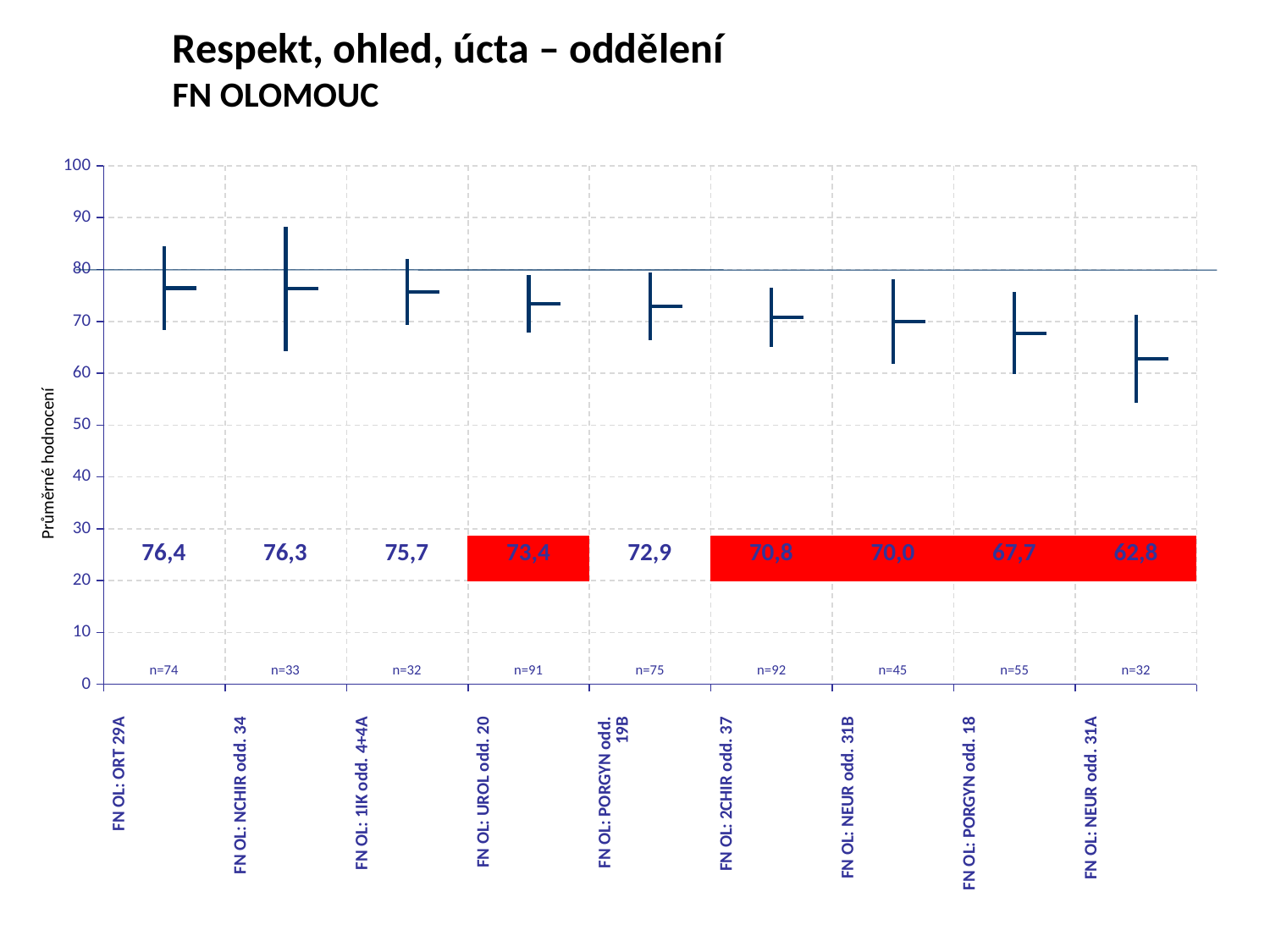
What is the average rating for FN OL: ORT 29A? 76,4 Which department has the highest average rating? FN OL: ORT 29A Which department has the lowest average rating? FN OL: NEUR odd. 31A What is the difference between the average ratings of FN OL: ORT 29A and FN OL: NEUR odd. 31A? 13,6 How many departments are shown on the chart? 9 Is the average rating for FN OL: NEUR odd. 31B greater or less than 80? less What is the number of respondents (n) for FN OL: 2CHIR odd. 37? n=92 What is the average rating for FN OL: NEUR odd. 31A? 62,8 What is the average rating for FN OL: UROL odd. 20? 73,4 What is the label of the vertical axis? Průměrné hodnocení Which has a higher average rating, FN OL: PORGYN odd. 19B or FN OL: PORGYN odd. 18? FN OL: PORGYN odd. 19B Do the average ratings rise or fall from left to right along the x axis? fall